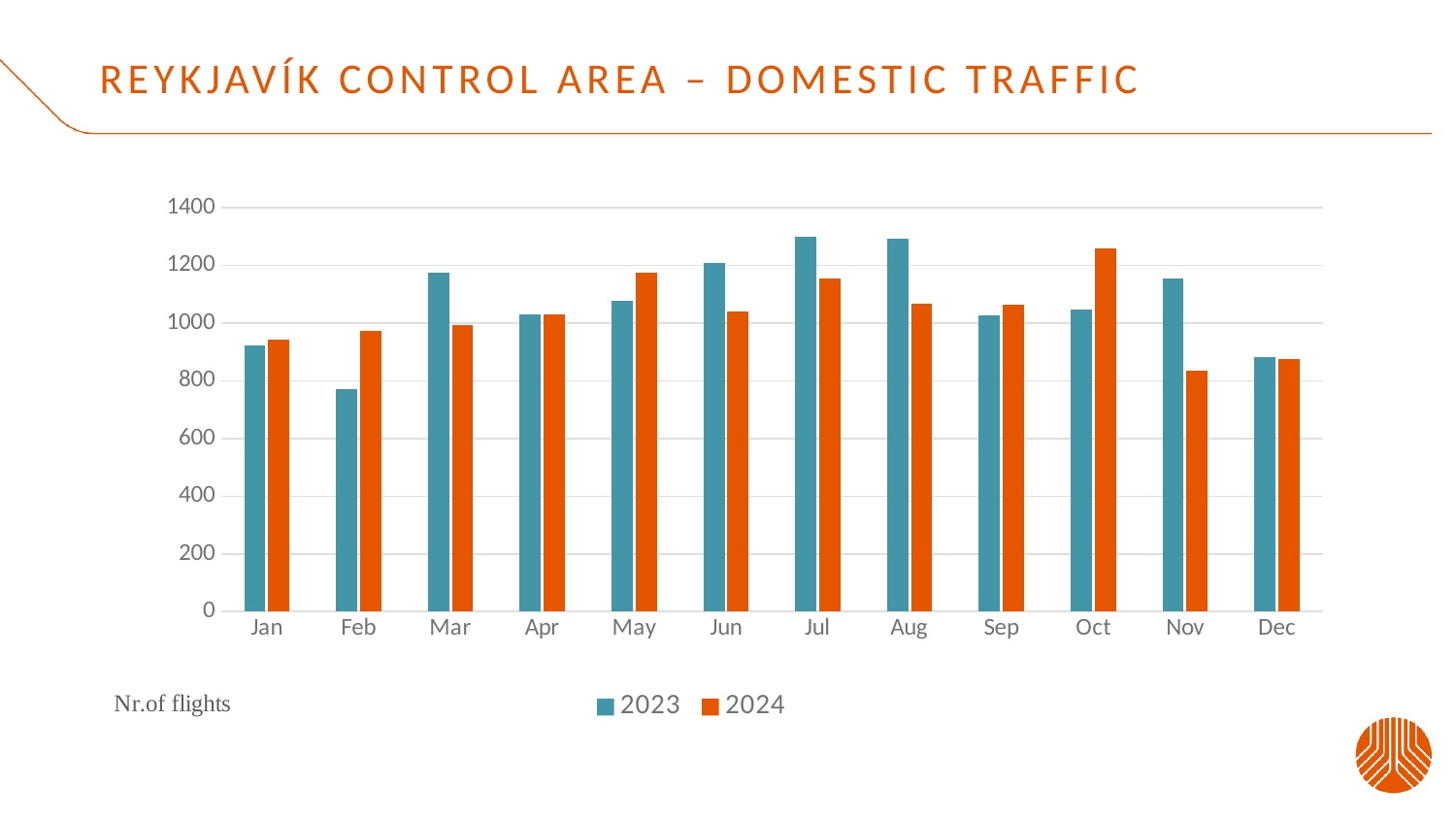
In February, which series has the larger value, 2023 or 2024? 2024 How many series does the legend list? 2 Is the value for Jul in 2023 greater or less than 1200? greater In October, which series has the larger value, 2023 or 2024? 2024 Is the value for Nov in 2024 greater or less than 1000? less Which month has the lowest value for 2024? Nov Which month has the highest value for 2024? Oct In March, which series has the larger value, 2023 or 2024? 2023 How many months are shown on the x axis? 12 What kind of chart is shown on the slide? bar chart Which month has the lowest value for 2023? Feb Is the value for Feb in 2023 greater or less than 800? less